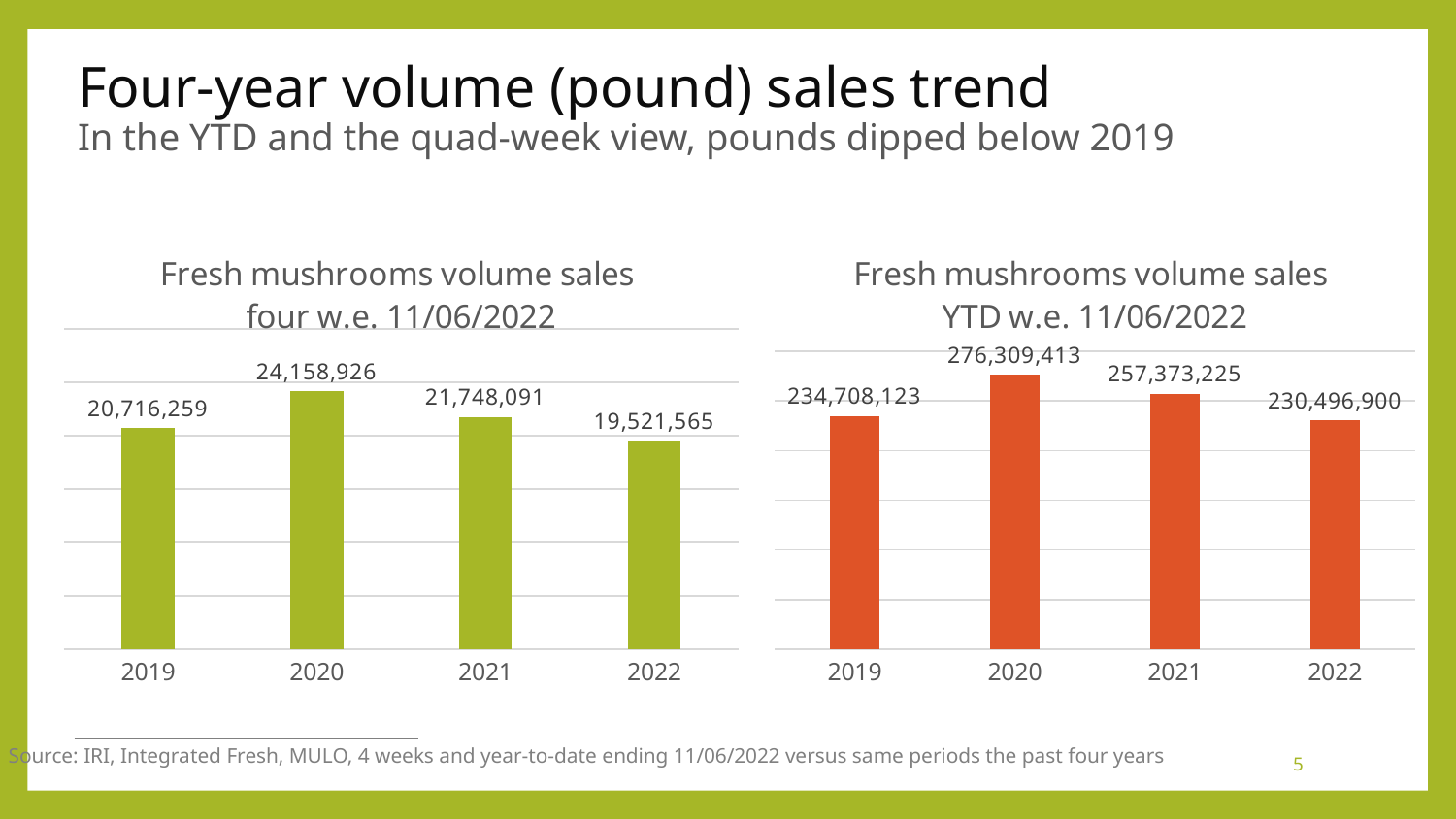
In the 'Fresh mushrooms volume sales four w.e. 11/06/2022' chart, what is the value for 2020? 24,158,926 In the 'Fresh mushrooms volume sales four w.e. 11/06/2022' chart, what is the difference between the 2020 and 2019 values? 3,442,667 What kind of chart is the 'Fresh mushrooms volume sales YTD w.e. 11/06/2022' chart? Bar chart In the 'Fresh mushrooms volume sales YTD w.e. 11/06/2022' chart, how much lower is the 2022 value than the 2019 value? 4,211,223 In the 'Fresh mushrooms volume sales YTD w.e. 11/06/2022' chart, which year has the highest value? 2020 In the 'Fresh mushrooms volume sales four w.e. 11/06/2022' chart, do the values rise or fall from 2020 to 2022? Fall In the 'Fresh mushrooms volume sales YTD w.e. 11/06/2022' chart, what is the value for 2021? 257,373,225 How many years are shown on the x axis of the 'Fresh mushrooms volume sales four w.e. 11/06/2022' chart? 4 In the 'Fresh mushrooms volume sales four w.e. 11/06/2022' chart, which year has the lowest value? 2022 What is the title of the chart on the left side of the slide? Fresh mushrooms volume sales four w.e. 11/06/2022 What colour are the bars in the 'Fresh mushrooms volume sales YTD w.e. 11/06/2022' chart? Orange In the 'Fresh mushrooms volume sales YTD w.e. 11/06/2022' chart, which is larger, the value for 2021 or the value for 2022? 2021